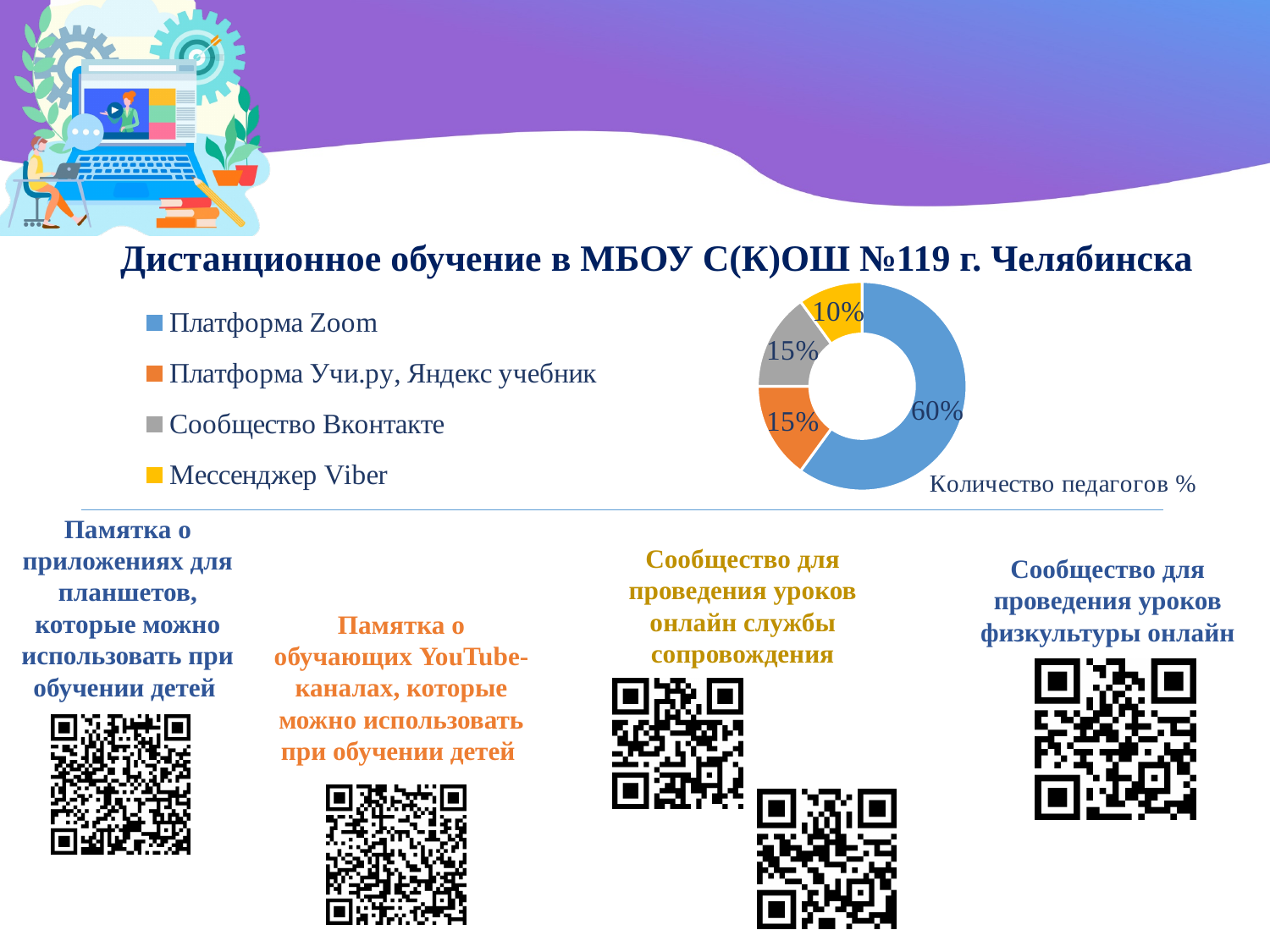
What percentage is shown for Мессенджер Viber? 10% What label appears next to the chart describing what the values represent? Количество педагогов % Which category has the smallest share of the chart? Мессенджер Viber Which category has the largest share of the chart? Платформа Zoom What percentage is shown for Платформа Учи.ру, Яндекс учебник? 15% How many categories does the chart show? 4 Which is larger, the share for Платформа Zoom or the share for Сообщество Вконтакте? Платформа Zoom What is the difference in percentage points between Платформа Zoom and Мессенджер Viber? 50 What percentage is shown for Сообщество Вконтакте? 15% What colour is the segment for Мессенджер Viber? yellow What percentage is shown for Платформа Zoom? 60% What kind of chart is shown on the slide? doughnut chart